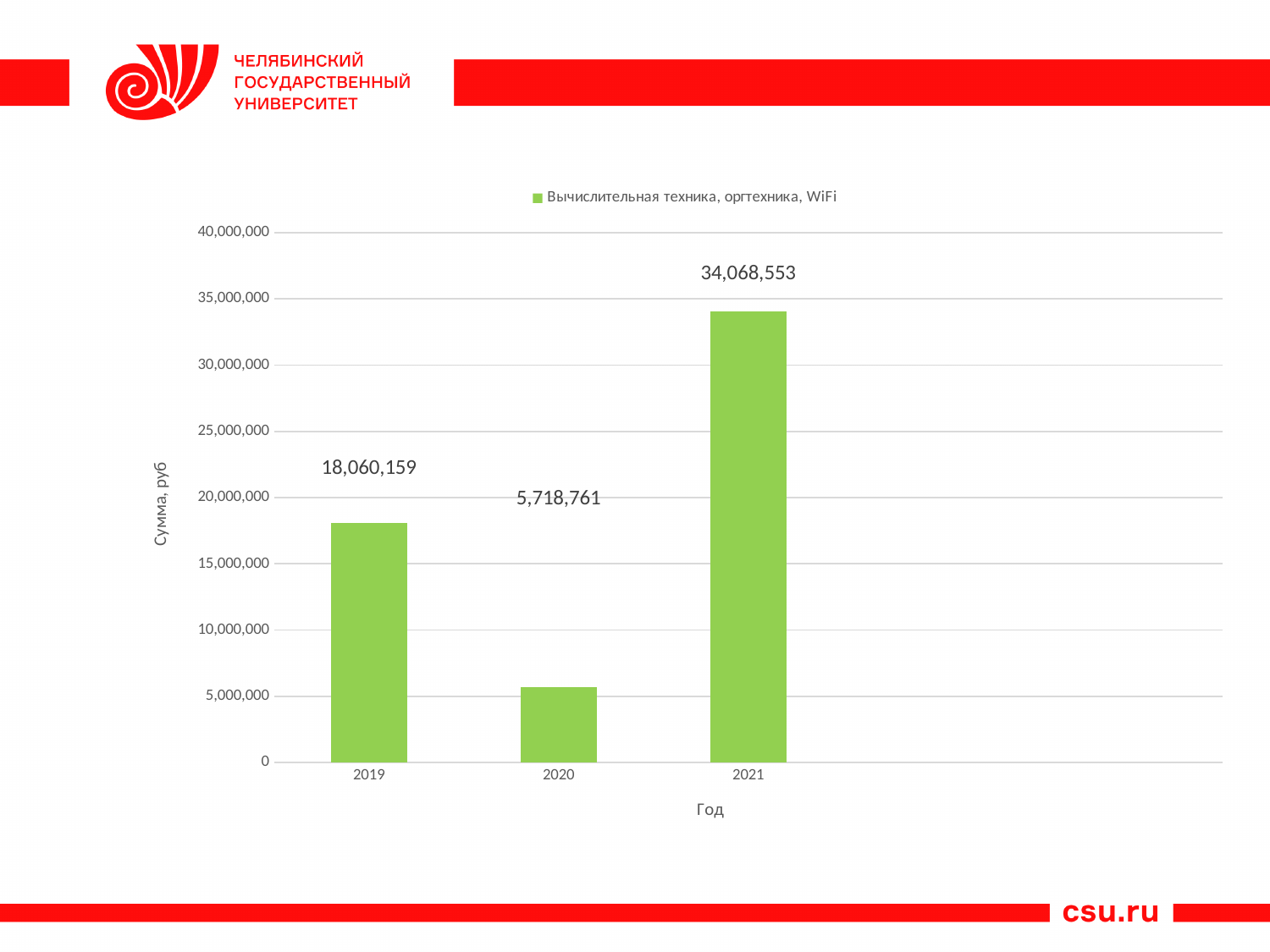
What series name does the legend show? Вычислительная техника, оргтехника, WiFi What is the difference between the values for 2021 and 2019? 16,008,394 Which is larger, the value for 2019 or the value for 2020? 2019 What is the value for 2019? 18,060,159 Is the value for 2021 greater or less than 30,000,000? greater How many years are shown on the x axis? 3 Which year has the highest value? 2021 Which year has the lowest value? 2020 What is the value for 2021? 34,068,553 What is the value for 2020? 5,718,761 What is the difference between the values for 2019 and 2020? 12,341,398 What kind of chart is shown on the slide? bar chart